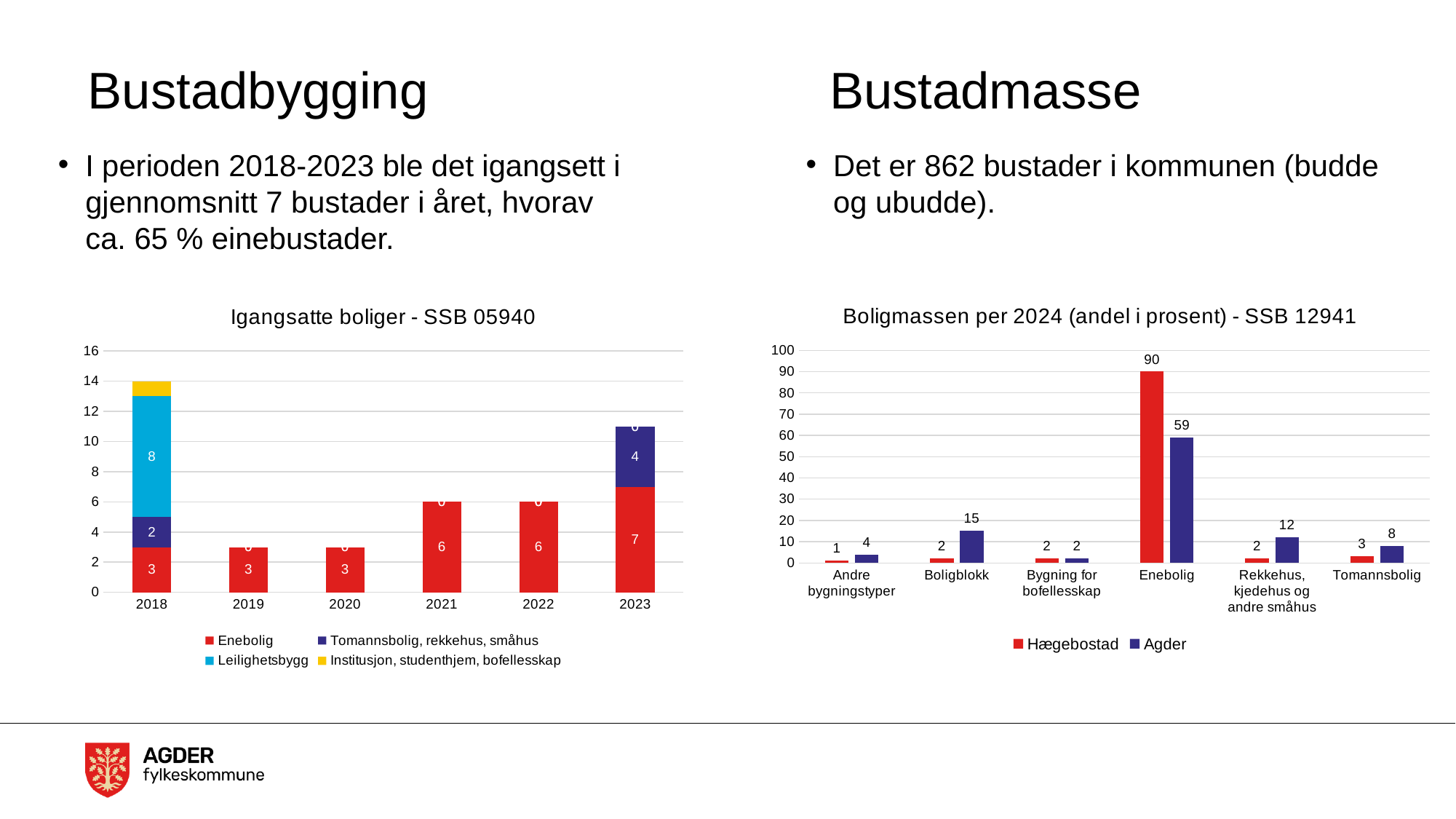
In the chart 'Igangsatte boliger - SSB 05940', what is the Leilighetsbygg value for 2018? 8 In the chart 'Igangsatte boliger - SSB 05940', what is the Enebolig value for 2023? 7 In the chart 'Boligmassen per 2024 (andel i prosent) - SSB 12941', what is the Agder value for Boligblokk? 15 In the chart 'Igangsatte boliger - SSB 05940', how many series does the legend list? 4 In the chart 'Boligmassen per 2024 (andel i prosent) - SSB 12941', what is the Hægebostad value for Enebolig? 90 In the chart 'Igangsatte boliger - SSB 05940', how many years are shown on the x axis? 6 In the chart 'Boligmassen per 2024 (andel i prosent) - SSB 12941', which category has the highest Agder value? Enebolig In the chart 'Boligmassen per 2024 (andel i prosent) - SSB 12941', what is the difference between the Hægebostad and Agder values for Enebolig? 31 In the chart 'Boligmassen per 2024 (andel i prosent) - SSB 12941', which is larger for Rekkehus, kjedehus og andre småhus: Hægebostad or Agder? Agder What kind of chart is 'Boligmassen per 2024 (andel i prosent) - SSB 12941'? Bar chart In the chart 'Igangsatte boliger - SSB 05940', what is the total of the stacked bar for 2023? 11 In the chart 'Igangsatte boliger - SSB 05940', which year has the lowest Enebolig value? 2018, 2019 and 2020 (all 3)